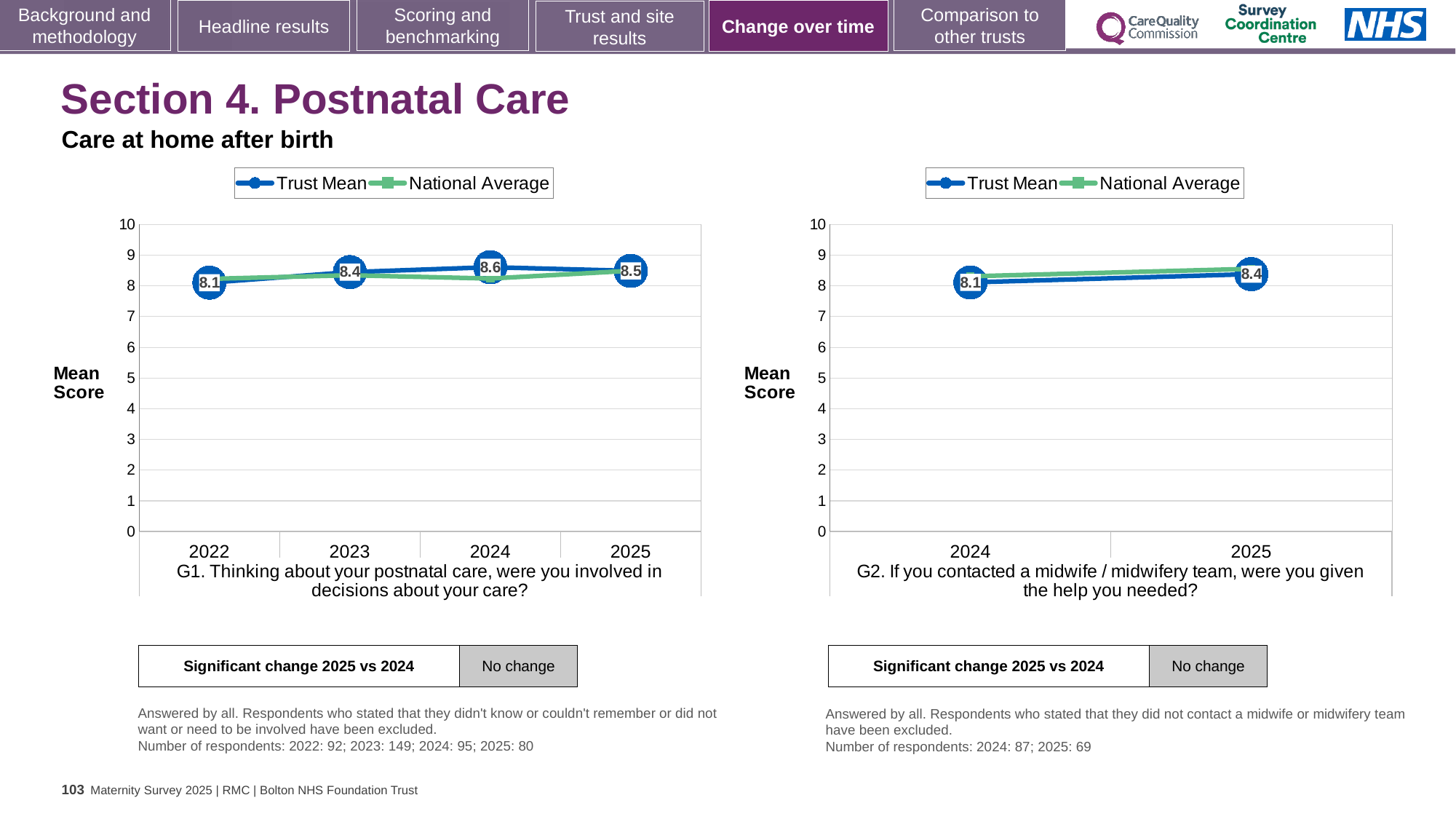
What kind of chart is the right chart (G2)? line chart In the right chart (G2), is the National Average for 2025 greater or less than 7? greater In the left chart (G1), which year has the lowest Trust Mean? 2022 How many series does the legend of the right chart (G2) list? 2 In the left chart (G1), what is the difference between the Trust Mean for 2024 and 2022? 0.5 In the right chart (G2), what is the Trust Mean for 2025? 8.4 In the left chart (G1), which year has the highest Trust Mean? 2024 In the left chart (G1), what is the Trust Mean for 2024? 8.6 In the left chart (G1), what is the Trust Mean for 2022? 8.1 How many years are shown on the x axis of the left chart (G1)? 4 In the left chart (G1), is the Trust Mean for 2023 larger or smaller than the Trust Mean for 2025? smaller In the right chart (G2), what is the difference between the Trust Mean for 2025 and 2024? 0.3